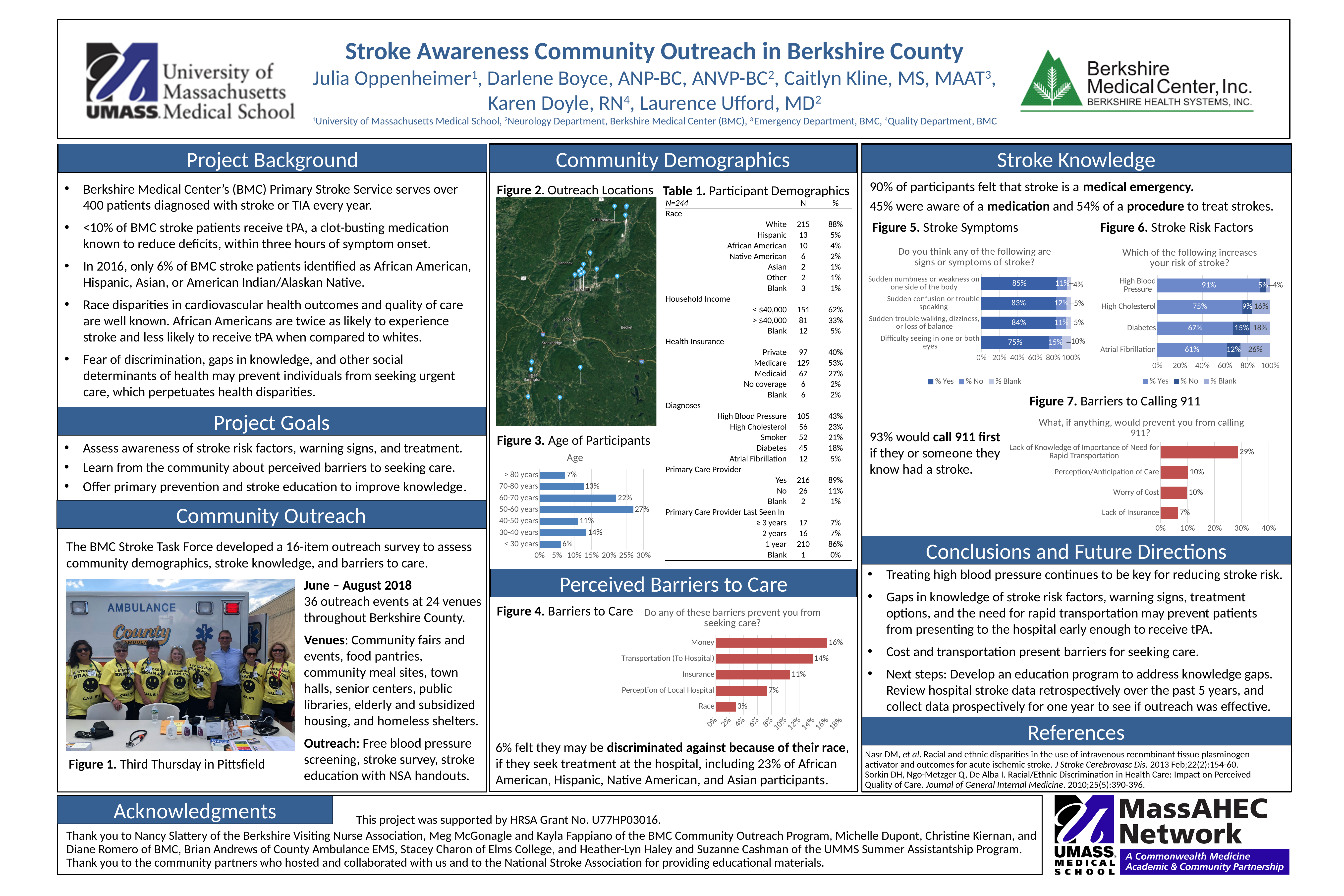
In Figure 6 (Stroke Risk Factors), what is the % Blank value for Atrial Fibrillation? 26% In Figure 4 (Barriers to Care), what is the difference between the Transportation (To Hospital) and Race percentages? 11% In Figure 7 (Barriers to Calling 911), is the value for Worry of Cost larger or smaller than the value for Lack of Insurance? Larger In Figure 6 (Stroke Risk Factors), which risk factor has the highest % Yes value? High Blood Pressure In Figure 5 (Stroke Symptoms), what percentage answered Yes for 'Difficulty seeing in one or both eyes'? 75% In Figure 3 (Age of Participants), which age group has the lowest percentage? < 30 years In Figure 3 (Age of Participants), what percentage of participants were aged 50-60 years? 27% What type of chart is Figure 4 (Barriers to Care)? Bar chart In Figure 3 (Age of Participants), how many age groups are shown? 7 In Figure 4 (Barriers to Care), what percentage of respondents cited Money as a barrier? 16% How many series does the legend of Figure 5 (Stroke Symptoms) list? 3 In Figure 7 (Barriers to Calling 911), which barrier has the highest percentage? Lack of Knowledge of Importance of Need for Rapid Transportation